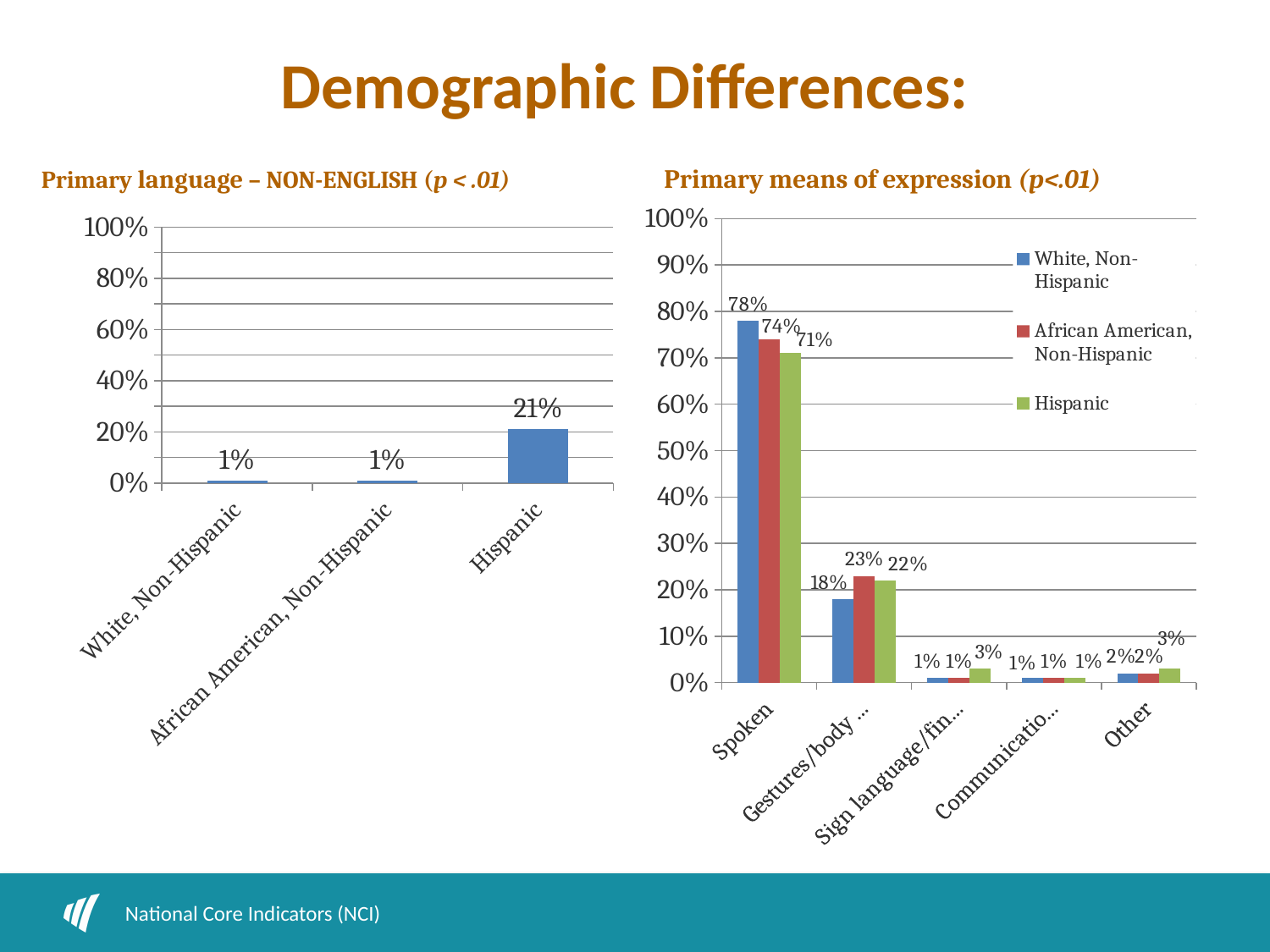
In the 'Primary language – NON-ENGLISH' chart, what is the value for Hispanic? 21% In the 'Primary means of expression' chart, what is the value for Hispanic in the Spoken category? 71% In the 'Primary language – NON-ENGLISH' chart, what is the difference between the Hispanic value and the White, Non-Hispanic value? 20% In the 'Primary means of expression' chart, which colour represents the Hispanic series? Green How many series does the legend list in the 'Primary means of expression' chart? 3 In the 'Primary means of expression' chart, which is larger for the Spoken category: White, Non-Hispanic or African American, Non-Hispanic? White, Non-Hispanic In the 'Primary means of expression' chart, what is the value for White, Non-Hispanic in the Spoken category? 78% In the 'Primary means of expression' chart, what is the value for African American, Non-Hispanic in the Other category? 2% What kind of chart is the 'Primary language – NON-ENGLISH' chart? Bar chart How many categories are shown in the 'Primary language – NON-ENGLISH' chart? 3 In the 'Primary language – NON-ENGLISH' chart, which category has the highest value? Hispanic In the 'Primary means of expression' chart, what is the difference between the White, Non-Hispanic and Hispanic values for Spoken? 7%